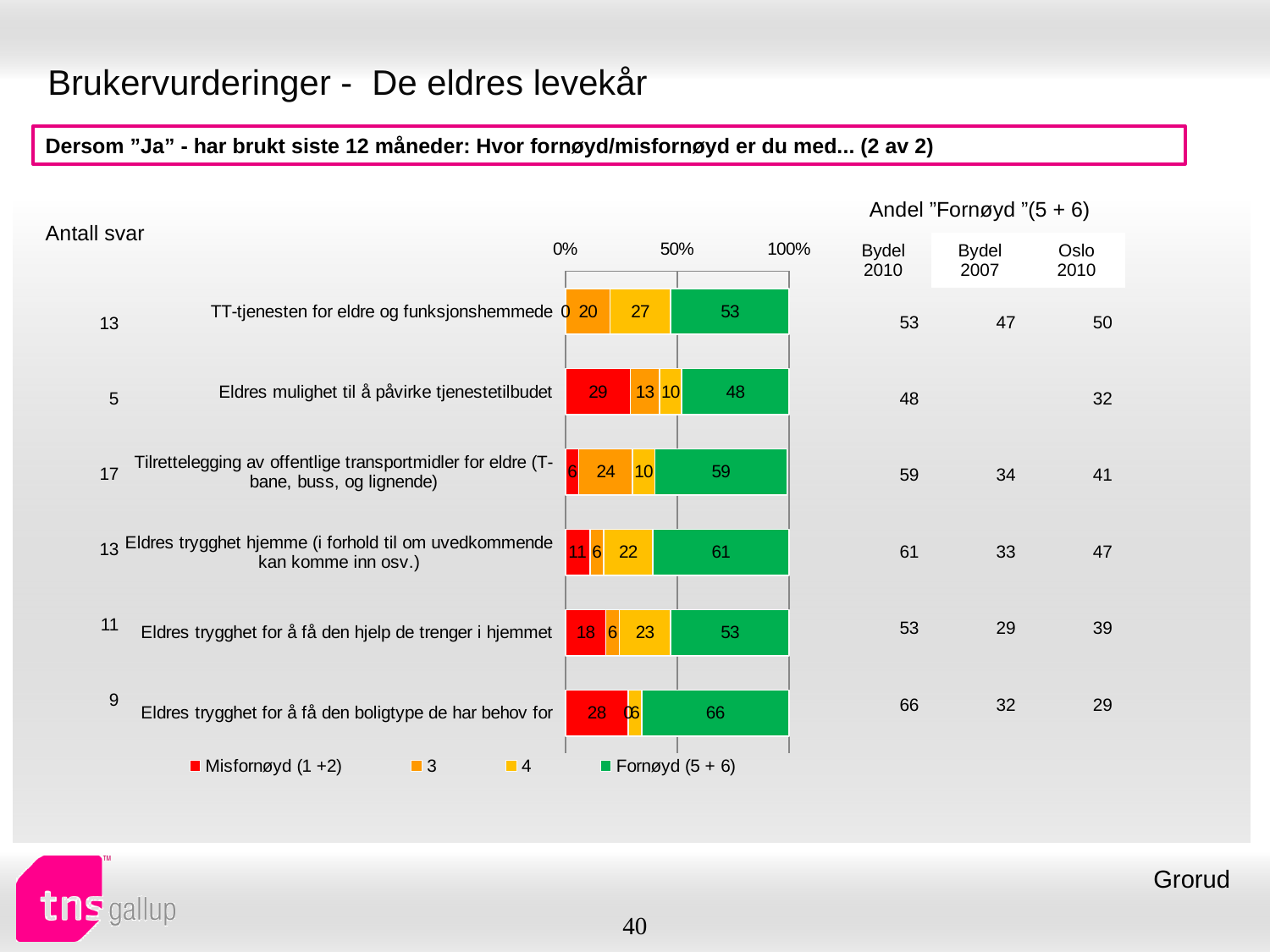
What is the value of series '4' for 'TT-tjenesten for eldre og funksjonshemmede'? 27 What kind of chart is shown on the slide? stacked bar chart How many categories are plotted in the chart? 6 What is the Misfornøyd (1 +2) value for 'Eldres mulighet til å påvirke tjenestetilbudet'? 29 What is the Fornøyd (5 + 6) value for 'Eldres trygghet for å få den boligtype de har behov for'? 66 What is the total of the stacked bar for 'Tilrettelegging av offentlige transportmidler for eldre'? 99 Which has a larger Misfornøyd (1 +2) value: 'Eldres trygghet hjemme' or 'Eldres trygghet for å få den hjelp de trenger i hjemmet'? Eldres trygghet for å få den hjelp de trenger i hjemmet Which category has the lowest Fornøyd (5 + 6) value? Eldres mulighet til å påvirke tjenestetilbudet Which category has the highest Fornøyd (5 + 6) value? Eldres trygghet for å få den boligtype de har behov for Which colour represents Fornøyd (5 + 6) in the legend? green What is the difference between the Fornøyd (5 + 6) values for 'Eldres trygghet hjemme' and 'Eldres trygghet for å få den hjelp de trenger i hjemmet'? 8 How many series does the legend list? 4